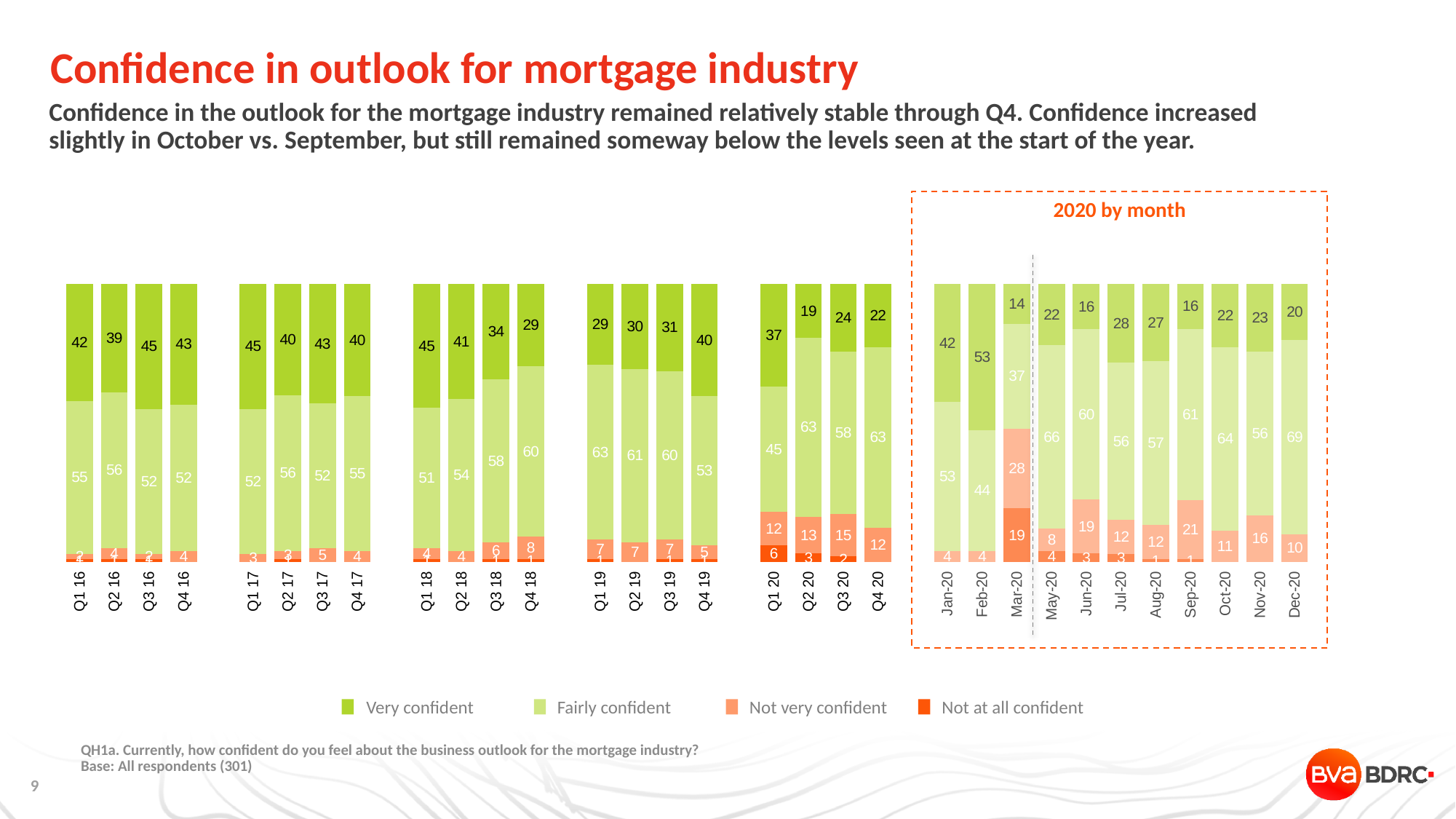
What kind of chart is shown on the slide? Stacked bar chart What is the 'Not at all confident' value for Q1 20? 6 What is the total of the four segments in the Mar-20 bar? 98 What is the difference between the 'Very confident' values for Q1 20 and Q2 20? 18 How many monthly bars are shown in the '2020 by month' section? 11 Among the 2020 monthly bars, which month has the highest 'Very confident' value? Feb-20 How many series does the legend list? 4 What is the 'Very confident' value for Q1 16? 42 What is the 'Not very confident' value for Mar-20? 28 Among the 2020 monthly bars, which month has the lowest 'Very confident' value? Mar-20 Which is larger, the 'Fairly confident' value for Sep-20 or for Nov-20? Sep-20 What is the 'Fairly confident' value for Dec-20? 69